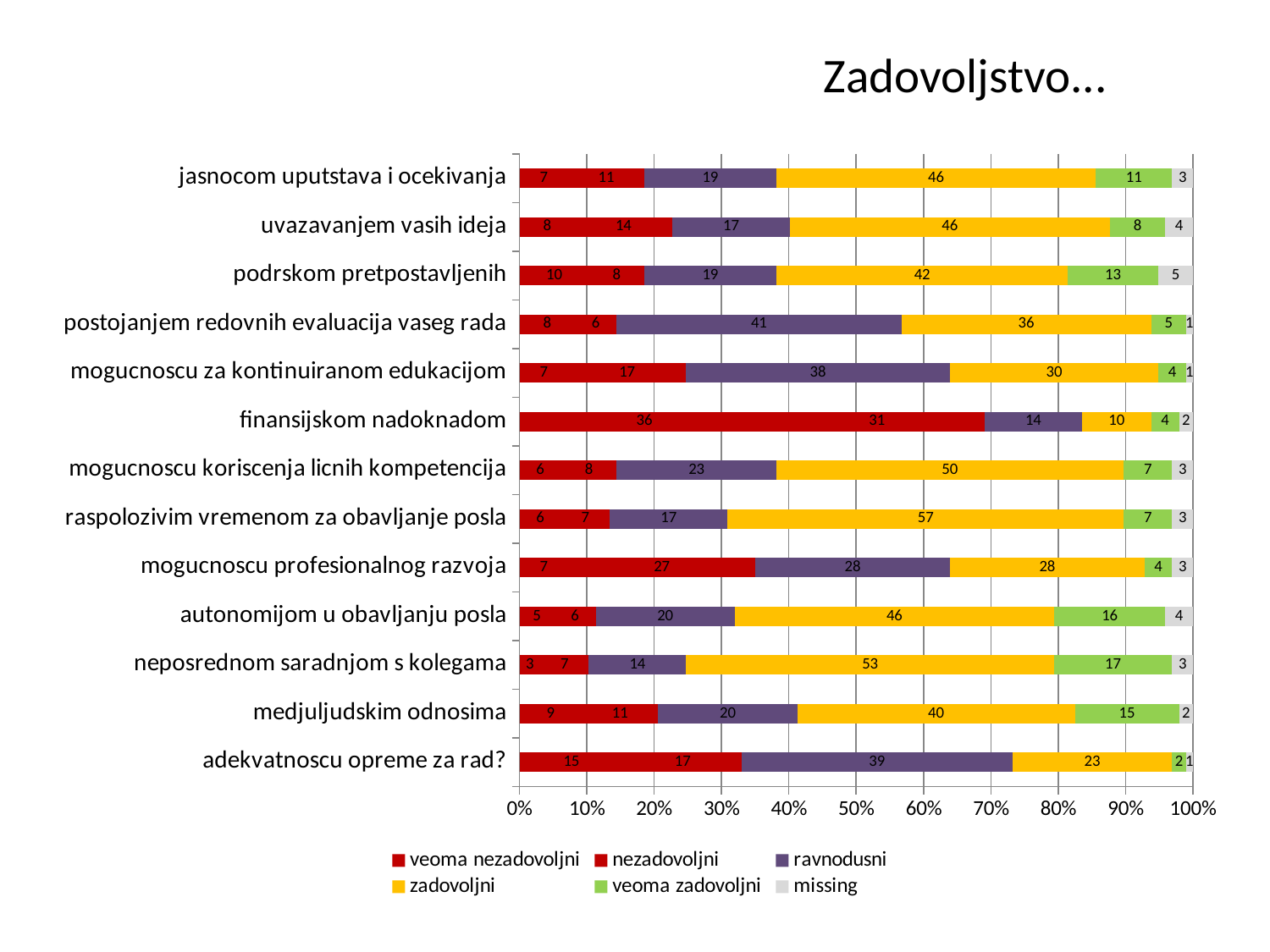
What is the 'veoma zadovoljni' value for 'autonomijom u obavljanju posla'? 16 Which category has the lowest 'zadovoljni' value? finansijskom nadoknadom Which is larger: the 'veoma zadovoljni' value for 'podrskom pretpostavljenih' or for 'uvazavanjem vasih ideja'? podrskom pretpostavljenih What is the 'ravnodusni' value for 'adekvatnoscu opreme za rad?'? 39 Which category has the highest 'zadovoljni' value? raspolozivim vremenom za obavljanje posla What is the title of the chart? Zadovoljstvo… How many series does the legend list? 6 How many categories are plotted on the chart? 13 What kind of chart is shown on the slide? stacked bar chart What is the difference between the 'zadovoljni' values for 'jasnocom uputstava i ocekivanja' and 'medjuljudskim odnosima'? 6 What is the 'zadovoljni' value for 'raspolozivim vremenom za obavljanje posla'? 57 Which category has the highest 'ravnodusni' value? postojanjem redovnih evaluacija vaseg rada